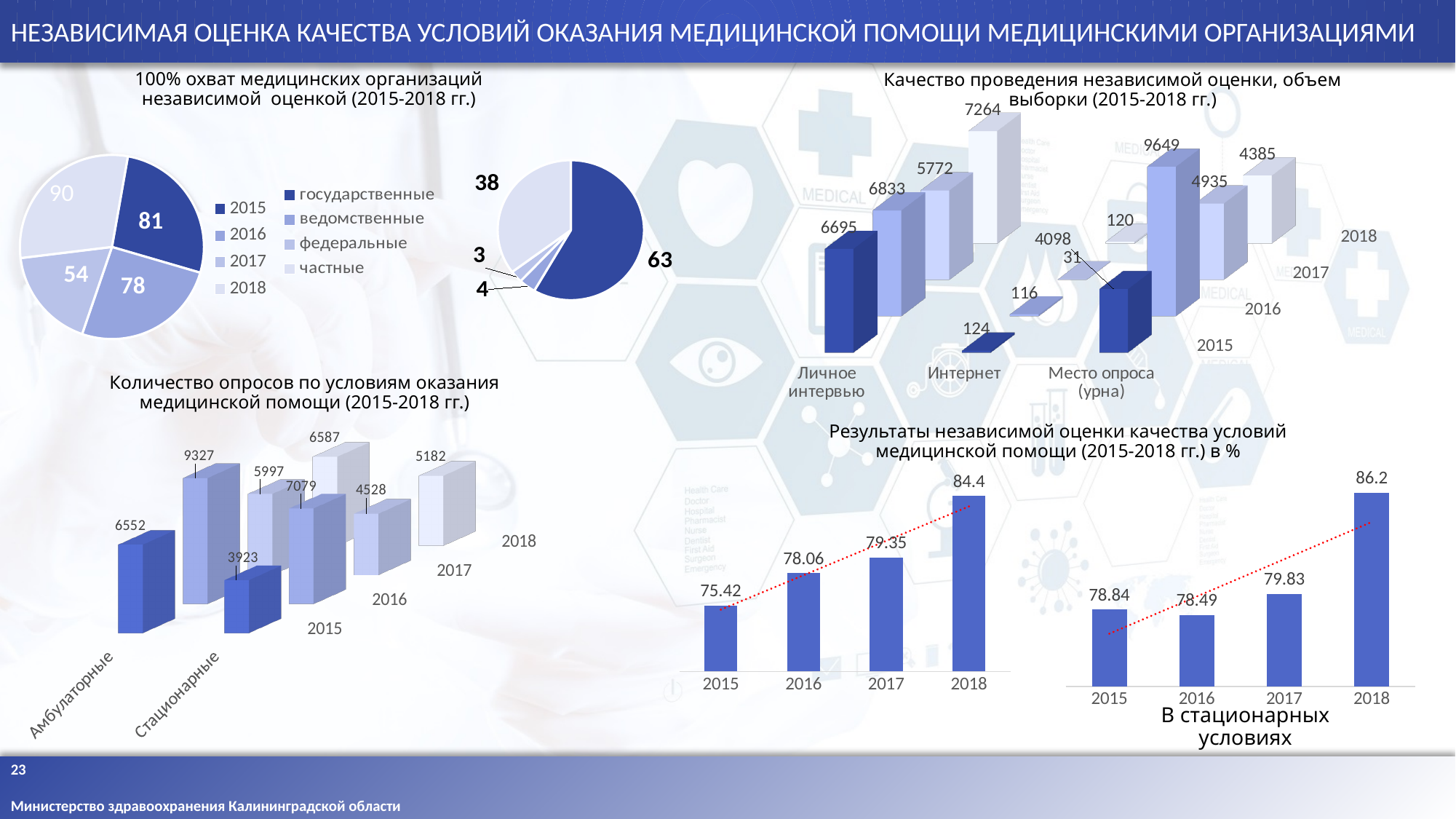
In the pie chart titled '100% охват медицинских организаций независимой оценкой (2015-2018 гг.)', which year has the largest slice? 2018 In the chart titled 'Качество проведения независимой оценки, объем выборки (2015-2018 гг.)', which year has the highest value for 'Место опроса (урна)'? 2016 In the pie chart with the legend 'государственные, ведомственные, федеральные, частные', what is the value for 'частные'? 38 In the pie chart with the legend 'государственные, ведомственные, федеральные, частные', how many categories does the legend list? 4 In the chart titled 'Качество проведения независимой оценки, объем выборки (2015-2018 гг.)', what kind of chart is it? bar chart In the chart titled 'Количество опросов по условиям оказания медицинской помощи (2015-2018 гг.)', what is the value for 'Амбулаторные' in 2016? 9327 In the left bar chart under 'Результаты независимой оценки качества условий медицинской помощи (2015-2018 гг.) в %', do the values rise or fall from 2015 to 2018? rise In the bar chart labelled 'В стационарных условиях', which is larger, the value for 2015 or 2016? 2015 In the chart titled 'Качество проведения независимой оценки, объем выборки (2015-2018 гг.)', what is the value for 'Личное интервью' in 2018? 7264 In the pie chart titled '100% охват медицинских организаций независимой оценкой (2015-2018 гг.)', what is the value for 2017? 54 In the chart titled 'Количество опросов по условиям оказания медицинской помощи (2015-2018 гг.)', what is the difference between 'Амбулаторные' and 'Стационарные' in 2015? 2629 In the left bar chart under 'Результаты независимой оценки качества условий медицинской помощи (2015-2018 гг.) в %', what is the value for 2015? 75.42